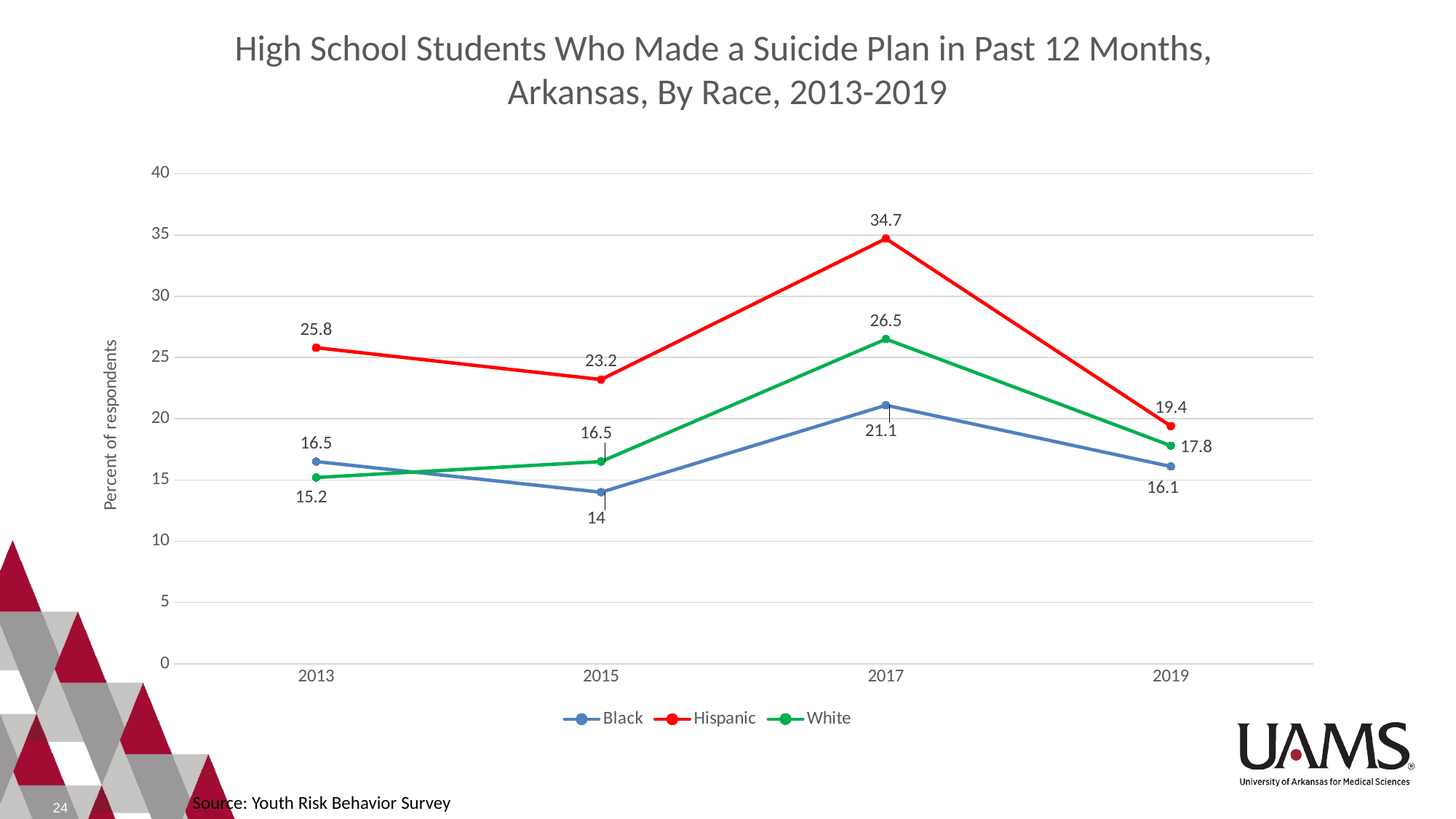
What was the value for White students in 2019? 17.8 What kind of chart is shown on the slide? Line chart How many years are shown on the x axis? 4 Is the value for Hispanic students in 2019 greater or less than 20? less In which year was the value for Hispanic students highest? 2017 What was the value for Hispanic students in 2017? 34.7 Which was larger in 2013, the value for Black students or for White students? Black What was the value for Black students in 2015? 14 What is the difference between the Hispanic and White values in 2017? 8.2 Did the value for White students rise or fall from 2017 to 2019? Fall How many series does the legend list? 3 In which year was the value for Black students lowest? 2015